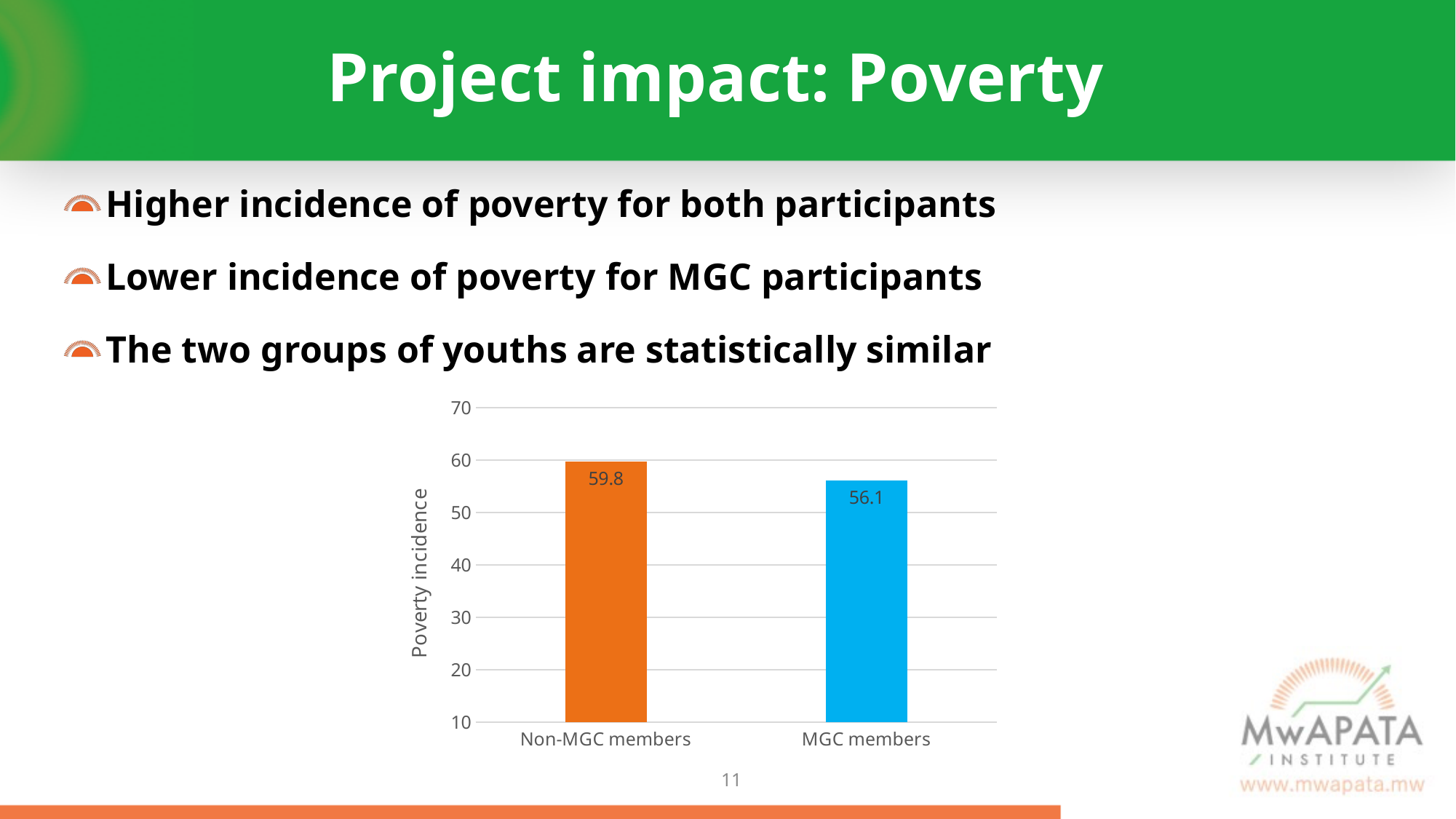
What is the poverty incidence for MGC members? 56.1 What is the label of the vertical axis of the chart? Poverty incidence What is the poverty incidence for Non-MGC members? 59.8 Is the poverty incidence for Non-MGC members greater or less than 50? greater Is the poverty incidence higher for Non-MGC members or MGC members? Non-MGC members Is the poverty incidence for MGC members greater or less than 60? less What kind of chart is shown on the slide? Bar chart What is the difference in poverty incidence between Non-MGC members and MGC members? 3.7 What colour is the bar for MGC members? Blue Which group has the lower poverty incidence? MGC members How many categories are shown on the chart? 2 Which group has the higher poverty incidence? Non-MGC members